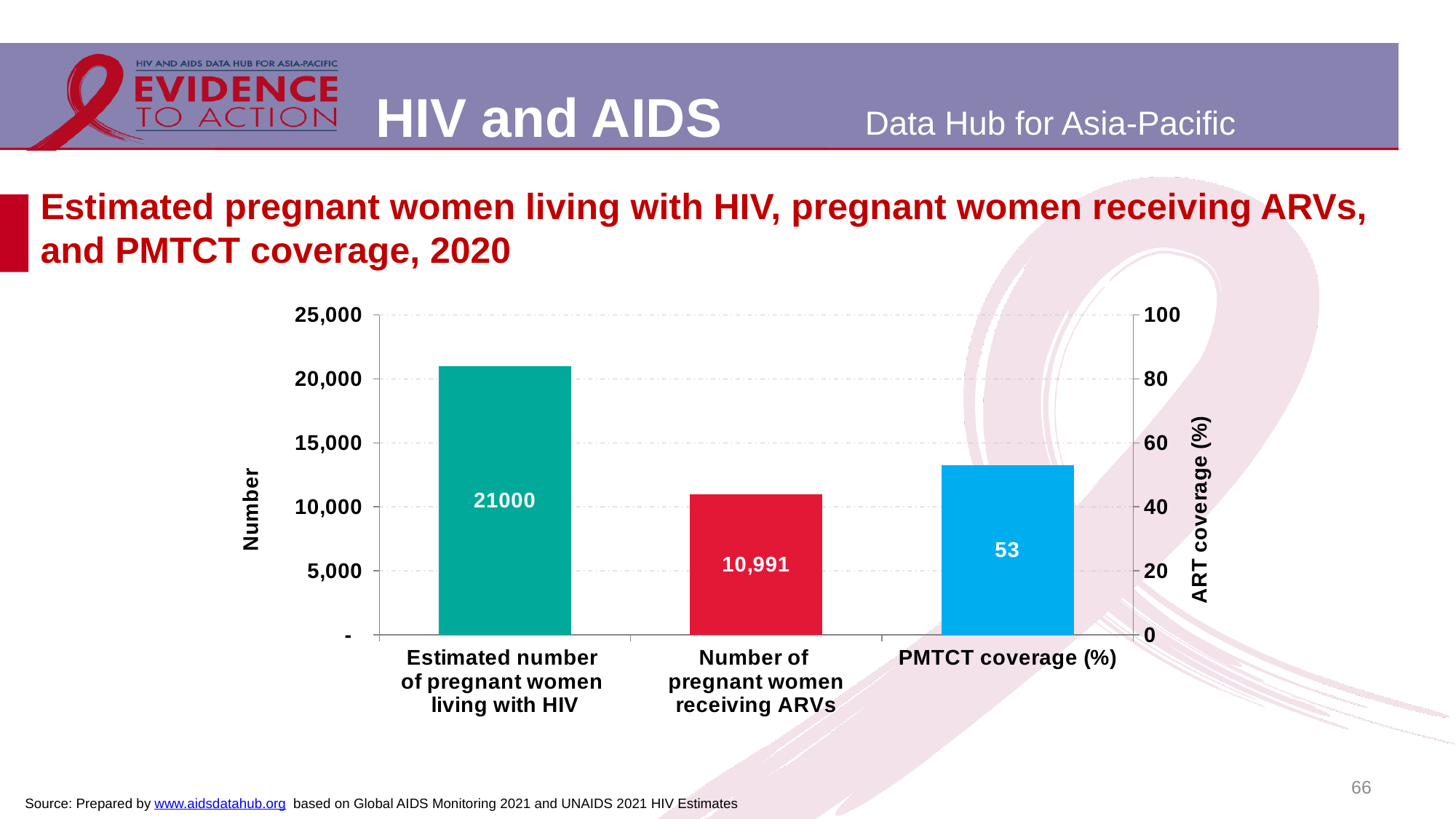
What year does the chart title refer to? 2020 What is the value for the number of pregnant women receiving ARVs? 10,991 Is the number of pregnant women receiving ARVs greater or less than 15,000? less What is the label of the right-hand vertical axis? ART coverage (%) What kind of chart is shown on the slide? Bar chart Which category has the tallest bar on the chart? Estimated number of pregnant women living with HIV What is the PMTCT coverage (%) shown on the chart? 53 What is the value for the estimated number of pregnant women living with HIV? 21000 Is the PMTCT coverage (%) greater or less than 40 on the right-hand axis? greater How many categories are plotted on the chart? 3 Which is larger: the estimated number of pregnant women living with HIV or the number of pregnant women receiving ARVs? Estimated number of pregnant women living with HIV What is the difference between the estimated number of pregnant women living with HIV and the number of pregnant women receiving ARVs? 10,009